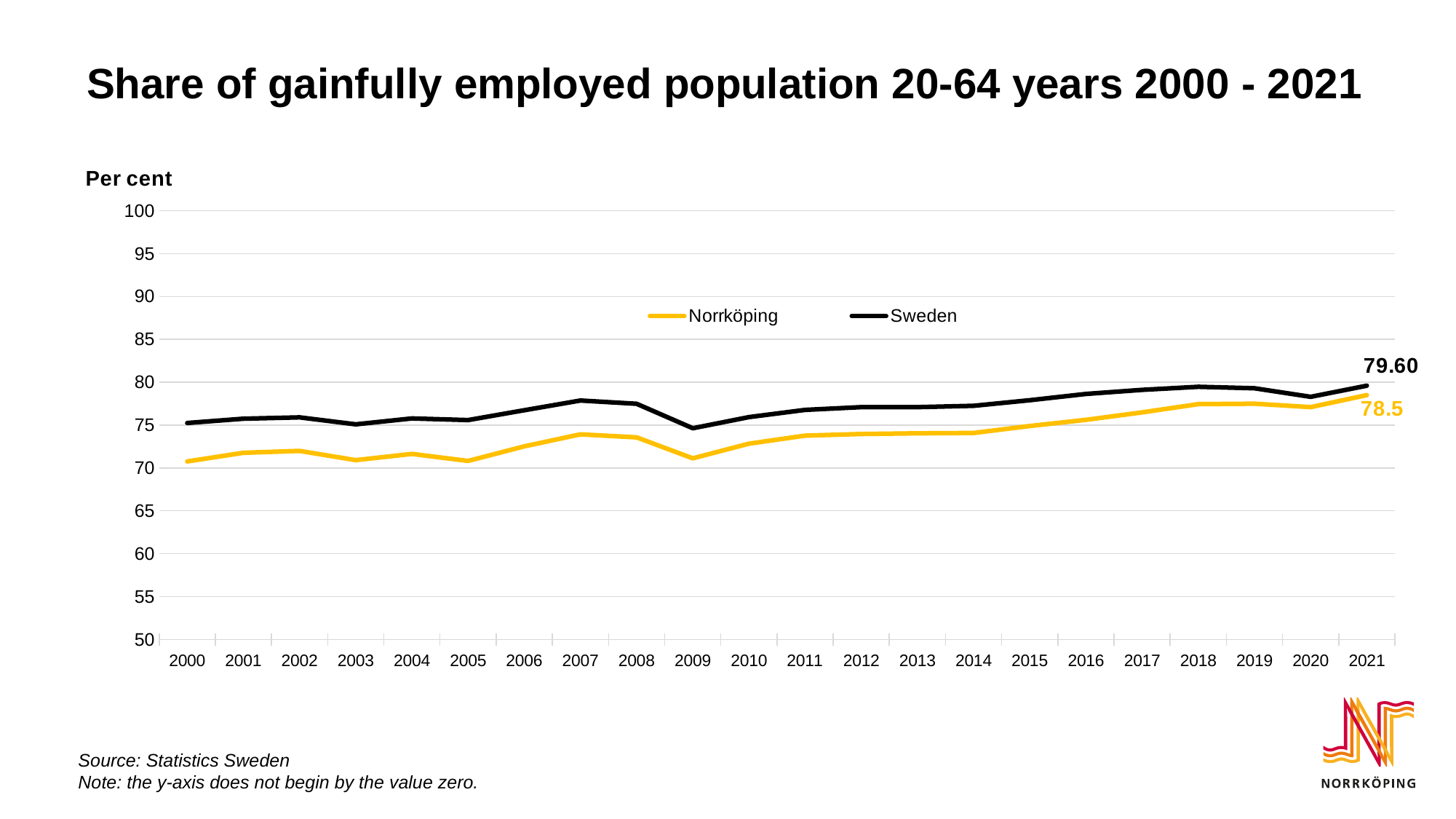
Is the value for Norrköping in 2000 greater or less than 75? less How many years are plotted along the x axis? 22 What is the value for Norrköping in 2021? 78.5 In 2021, which series has the higher value, Sweden or Norrköping? Sweden Is the value for Sweden in 2009 greater or less than 80? less Overall, does the Norrköping line rise or fall from 2000 to 2021? rise What is the value for Sweden in 2021? 79.60 What is the difference between the Sweden and Norrköping values in 2021? 1.1 What is the title of the chart? Share of gainfully employed population 20-64 years 2000 - 2021 What kind of chart is shown on the slide? line chart How many series does the legend list? 2 Is the value for Norrköping in 2009 greater or less than 70? greater